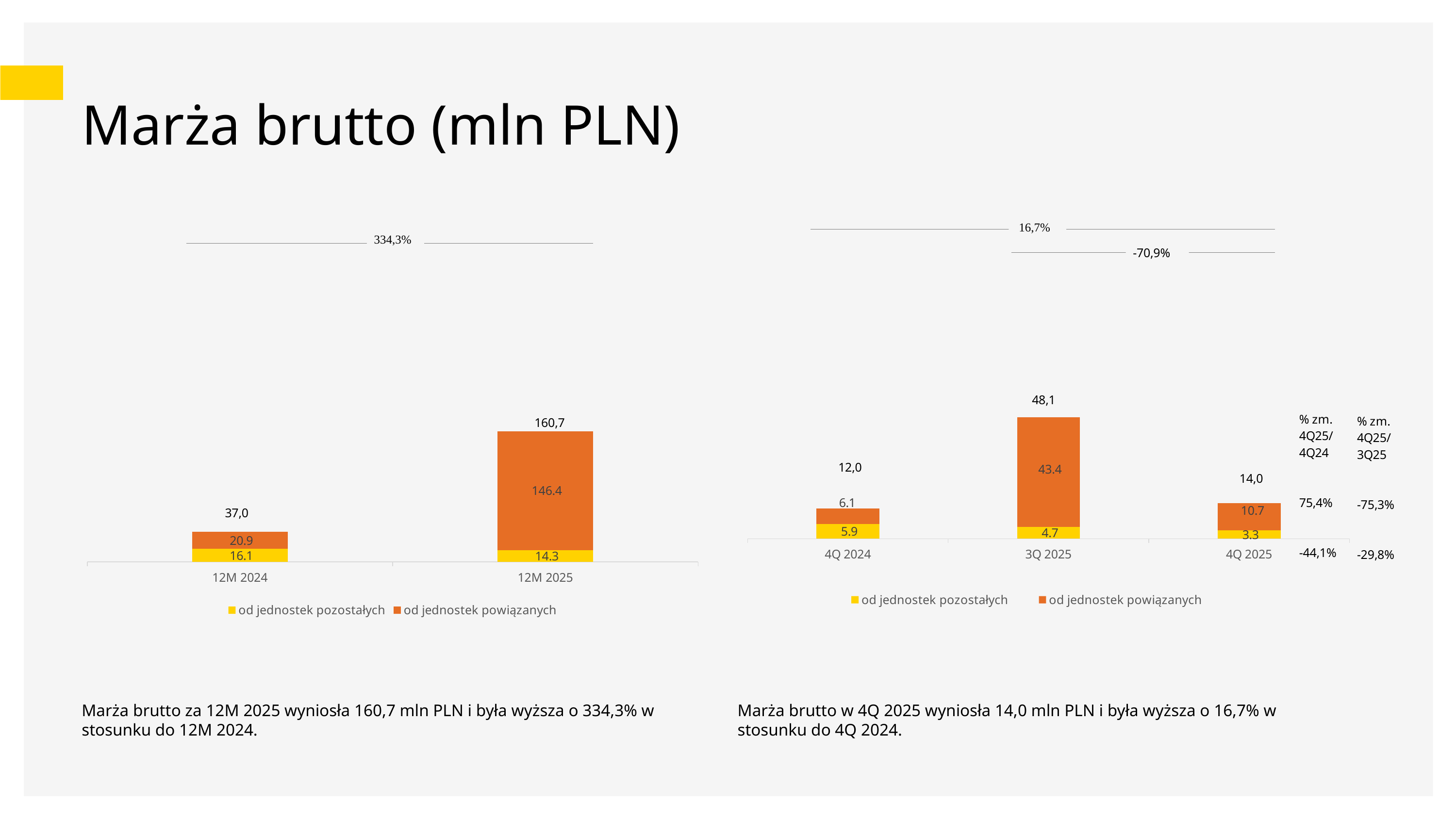
In the right chart, what is the value for 'od jednostek pozostałych' in 4Q 2025? 3.3 In the right chart, which quarter has the lowest value for 'od jednostek pozostałych'? 4Q 2025 In the right chart, what is the value for 'od jednostek powiązanych' in 3Q 2025? 43.4 In the right chart, how many quarters are shown on the x axis? 3 In the right chart, what is the total of the stacked bar for 4Q 2025? 14,0 In the left chart, what is the value for 'od jednostek powiązanych' in 12M 2025? 146.4 In the right chart, which quarter has the highest total gross margin? 3Q 2025 In the left chart, what kind of chart is shown? Stacked bar chart In the right chart, how many series does the legend list? 2 In the left chart, what is the value for 'od jednostek pozostałych' in 12M 2024? 16.1 In the left chart, what is the total of the stacked bar for 12M 2024? 37,0 In the left chart, what is the difference between the 'od jednostek powiązanych' values for 12M 2025 and 12M 2024? 125.5